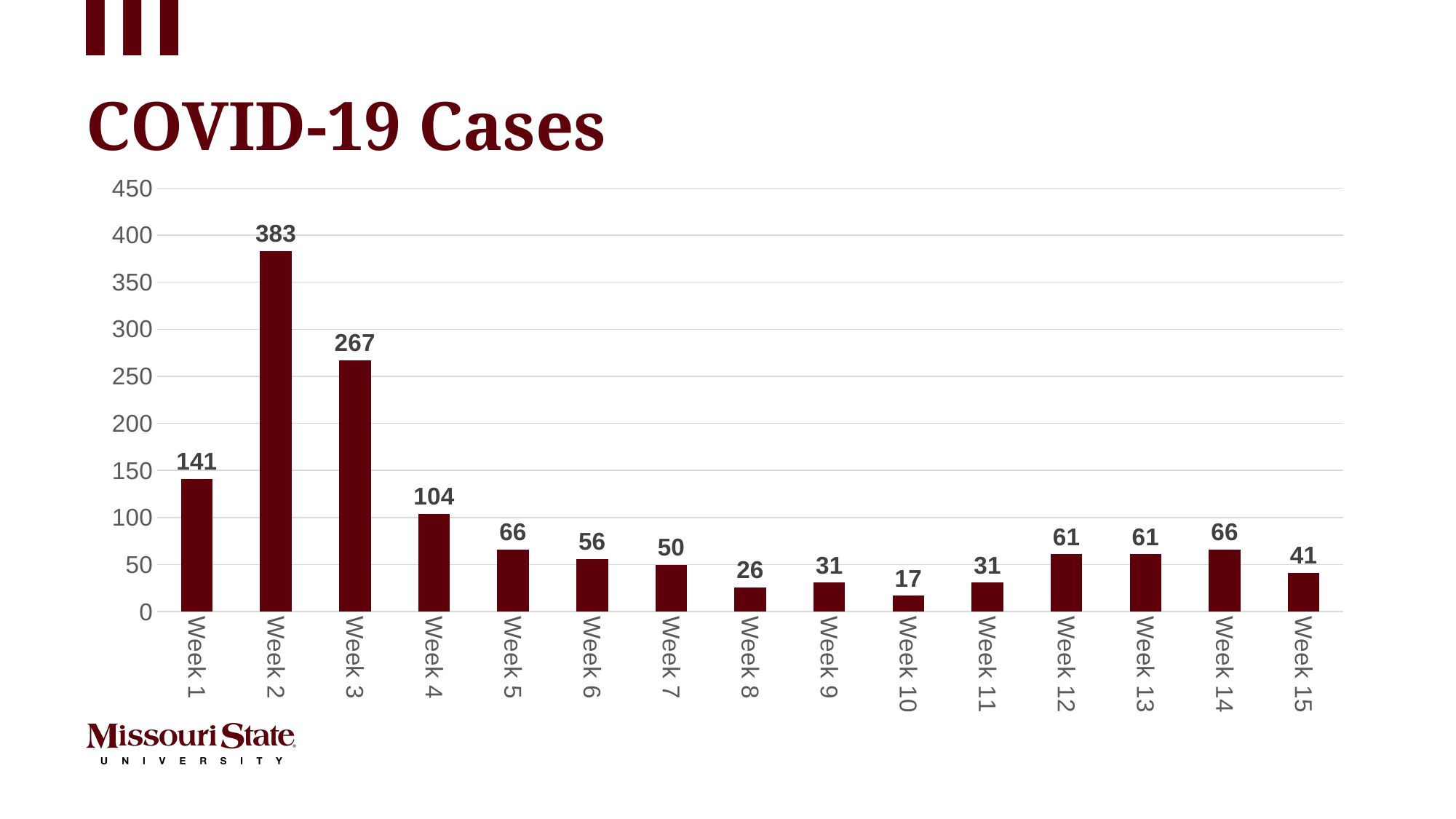
What is the value for Week 4? 104 How many weeks are shown on the x axis? 15 Is the value for Week 3 greater or less than 250? greater What kind of chart is shown on the slide? bar chart Which is larger, the value for Week 12 or the value for Week 15? Week 12 What is the difference between the values for Week 2 and Week 3? 116 What is the difference between the values for Week 1 and Week 4? 37 What is the title of the chart? COVID-19 Cases Which week has the highest number of cases? Week 2 Which week has the lowest number of cases? Week 10 What is the value for Week 10? 17 What is the value for Week 2? 383